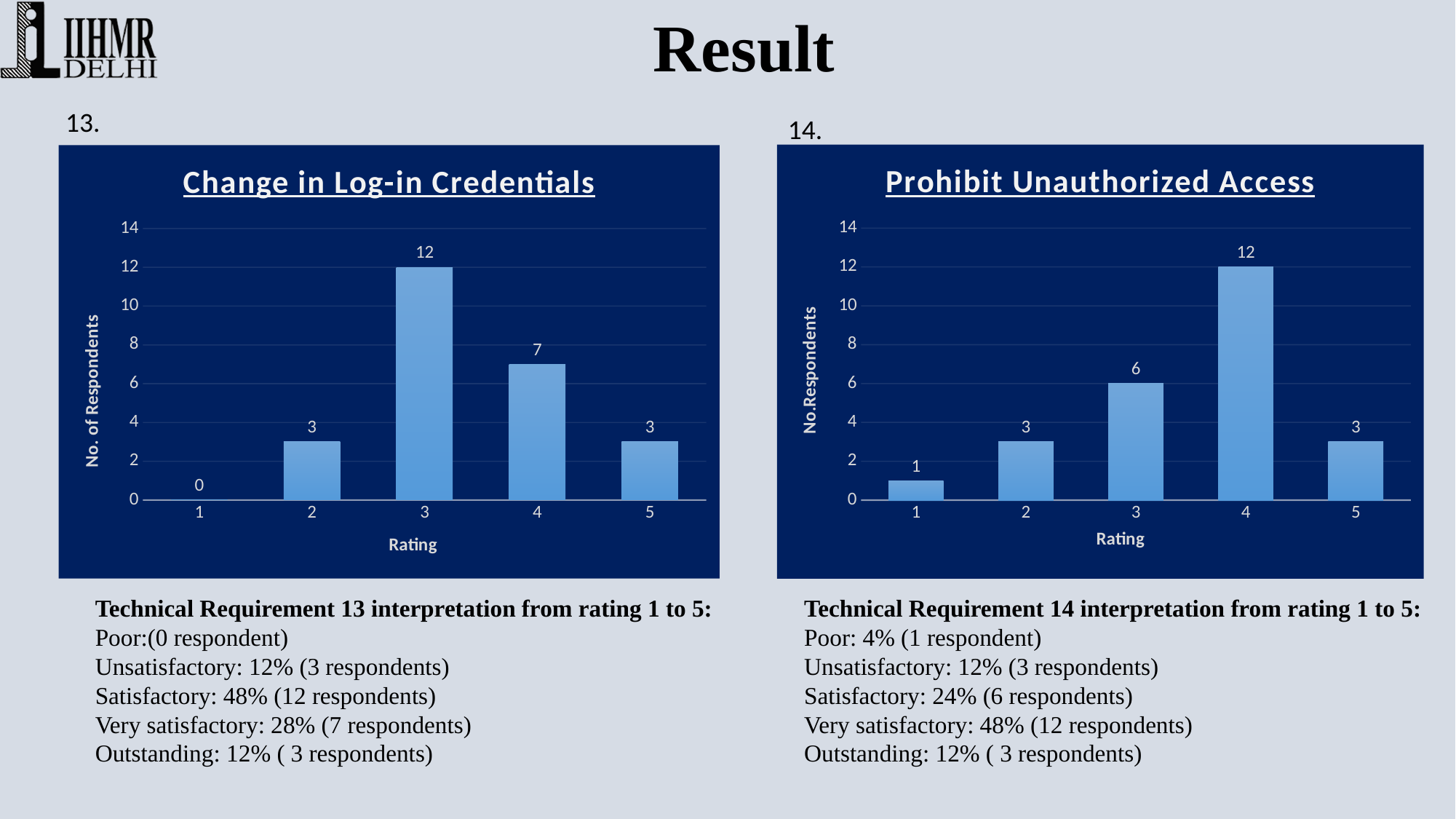
In the 'Prohibit Unauthorized Access' chart, which rating has the highest number of respondents? 4 In the 'Change in Log-in Credentials' chart, which rating has the highest number of respondents? 3 What type of chart is 'Change in Log-in Credentials'? Bar chart In the 'Change in Log-in Credentials' chart, what is the difference in respondents between rating 3 and rating 4? 5 In the 'Change in Log-in Credentials' chart, how many respondents gave a rating of 3? 12 In the 'Change in Log-in Credentials' chart, which rating has the lowest number of respondents? 1 In the 'Prohibit Unauthorized Access' chart, what is the difference in respondents between rating 4 and rating 3? 6 In the 'Prohibit Unauthorized Access' chart, how many respondents gave a rating of 1? 1 What is the y-axis label of the 'Change in Log-in Credentials' chart? No. of Respondents In the 'Prohibit Unauthorized Access' chart, which has more respondents: rating 2 or rating 3? Rating 3 How many rating categories are shown on the x axis of the 'Prohibit Unauthorized Access' chart? 5 In the 'Change in Log-in Credentials' chart, is the value for rating 4 greater or less than 6? greater